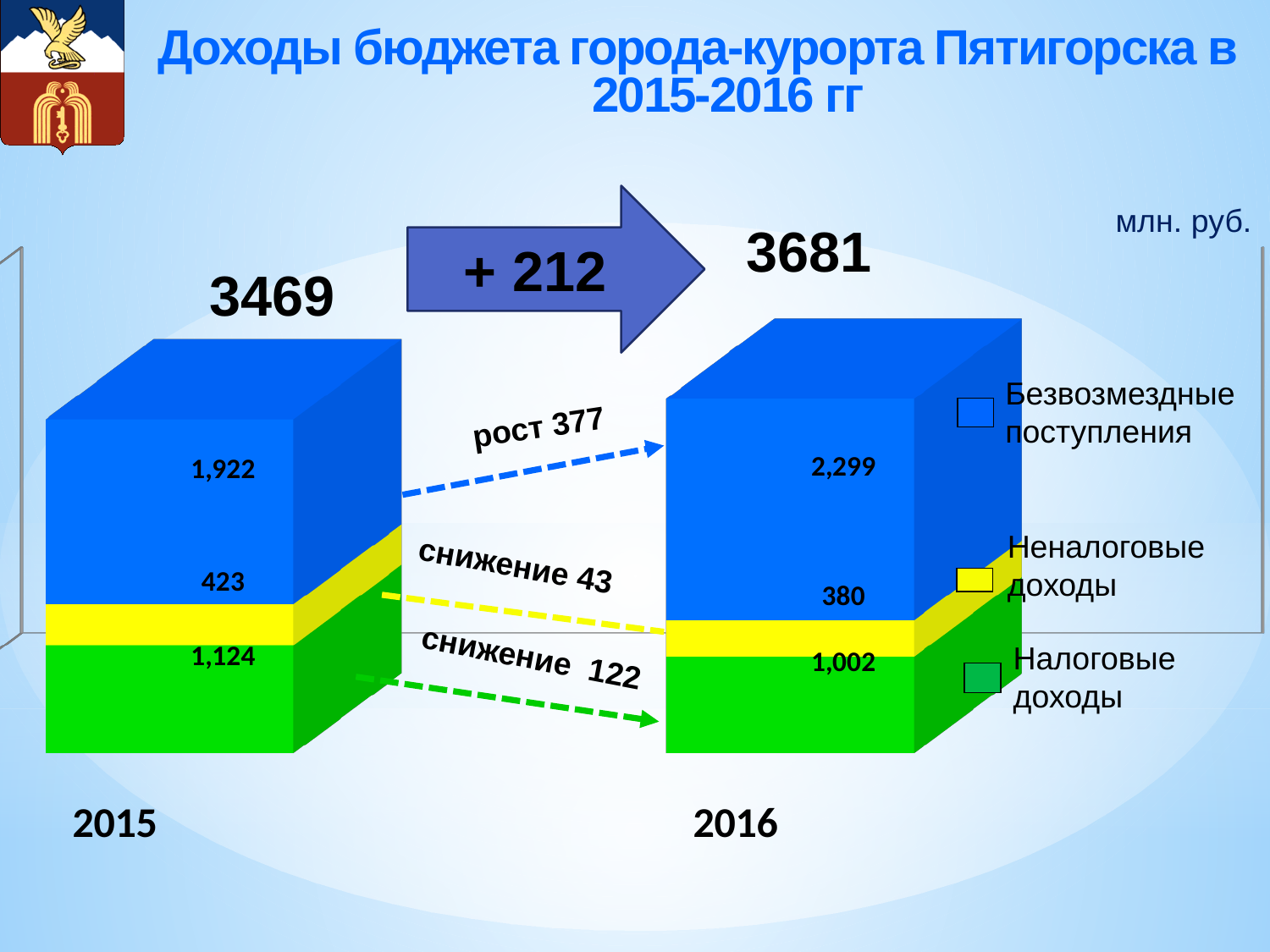
What kind of chart is shown on the slide? Stacked bar chart What is the value of Налоговые доходы for 2016? 1,002 What is the difference between Налоговые доходы in 2015 and 2016? 122 What is the value of Безвозмездные поступления for 2015? 1,922 How many series does the legend list? 3 What is the total of the stacked bar for 2016? 3681 What is the total of the stacked bar for 2015? 3469 Which series has the highest value in 2016? Безвозмездные поступления Which year has the larger value for Неналоговые доходы, 2015 or 2016? 2015 Which series has the lowest value in 2015? Неналоговые доходы What is the value of Неналоговые доходы for 2016? 380 By how much did Безвозмездные поступления change from 2015 to 2016? 377